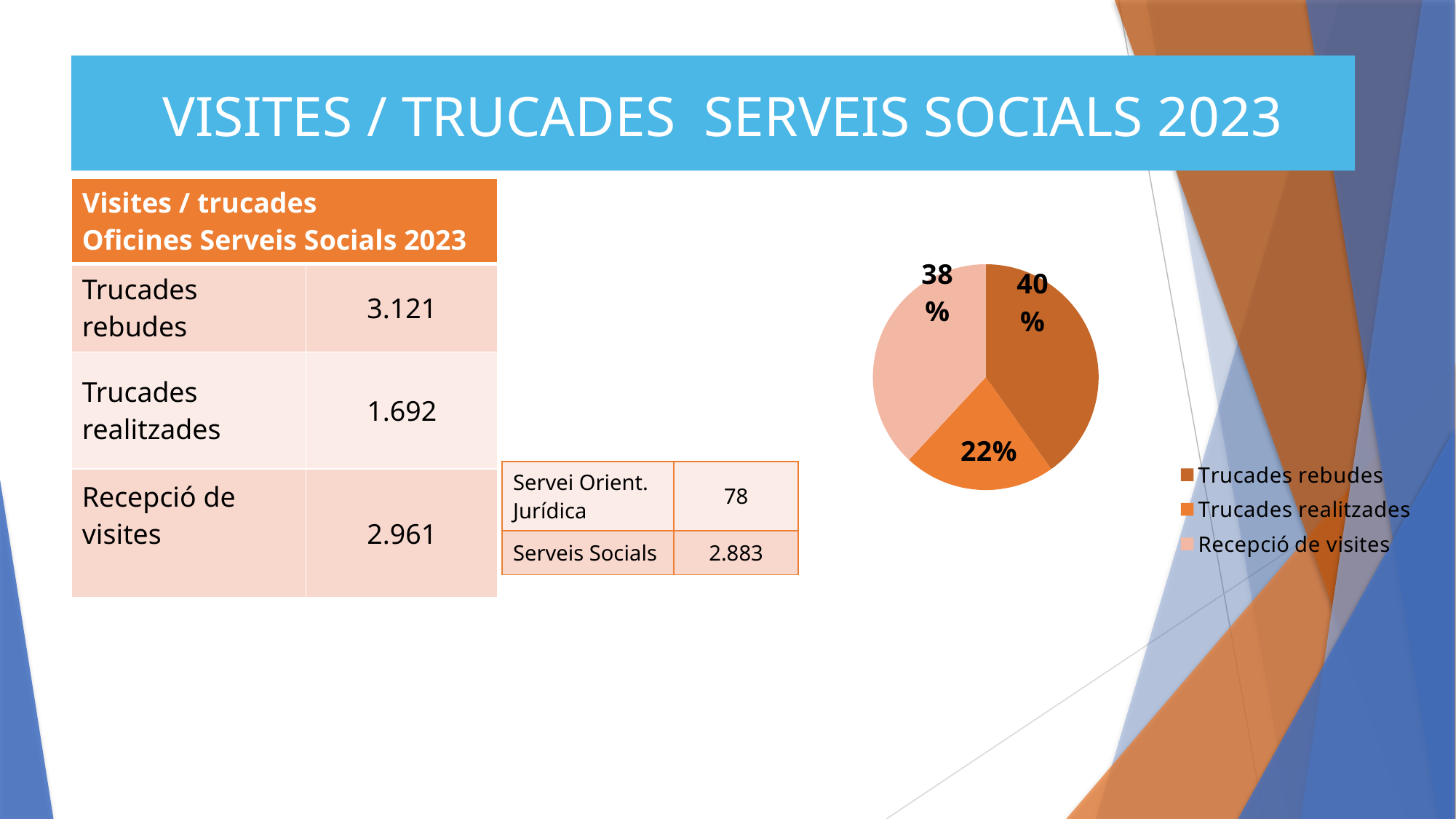
Which legend entry of the pie chart is shown in the lightest colour? Recepció de visites Which slice of the pie chart is the largest? Trucades rebudes In the pie chart, what is the difference in percentage points between Trucades rebudes and Trucades realitzades? 18 What kind of chart is shown on the slide? pie chart In the pie chart, which is larger: Trucades rebudes or Recepció de visites? Trucades rebudes What share of the pie chart does Trucades realitzades represent? 22% How many entries does the pie chart legend list? 3 What share of the pie chart does Trucades rebudes represent? 40% What share of the pie chart does Recepció de visites represent? 38% In the pie chart, what is the difference in percentage points between Recepció de visites and Trucades realitzades? 16 How many slices does the pie chart have? 3 Which slice of the pie chart is the smallest? Trucades realitzades